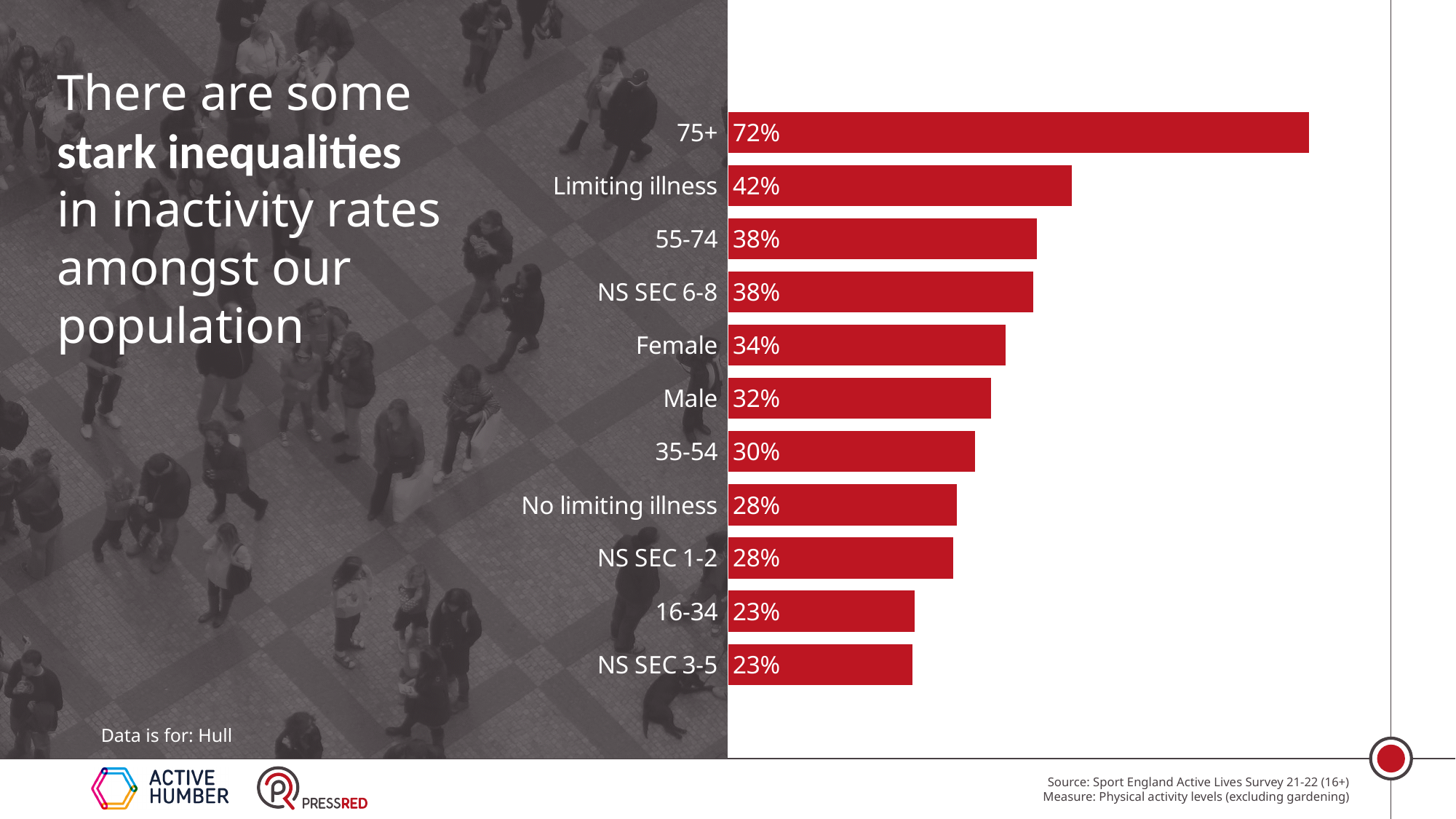
What is the inactivity rate for the 75+ group? 72% What is the inactivity rate for people with a limiting illness? 42% Which area is the data for, according to the slide? Hull Which has a higher inactivity rate, Limiting illness or No limiting illness? Limiting illness What is the difference in inactivity rate between Female and Male? 2% What is the inactivity rate for the 16-34 group? 23% What is the difference in inactivity rate between the 75+ group and the 16-34 group? 49% Which category has the highest inactivity rate? 75+ What kind of chart is shown on the slide? Bar chart Which has a higher inactivity rate, NS SEC 6-8 or NS SEC 1-2? NS SEC 6-8 What is the inactivity rate for Female? 34% How many categories are shown in the chart? 11